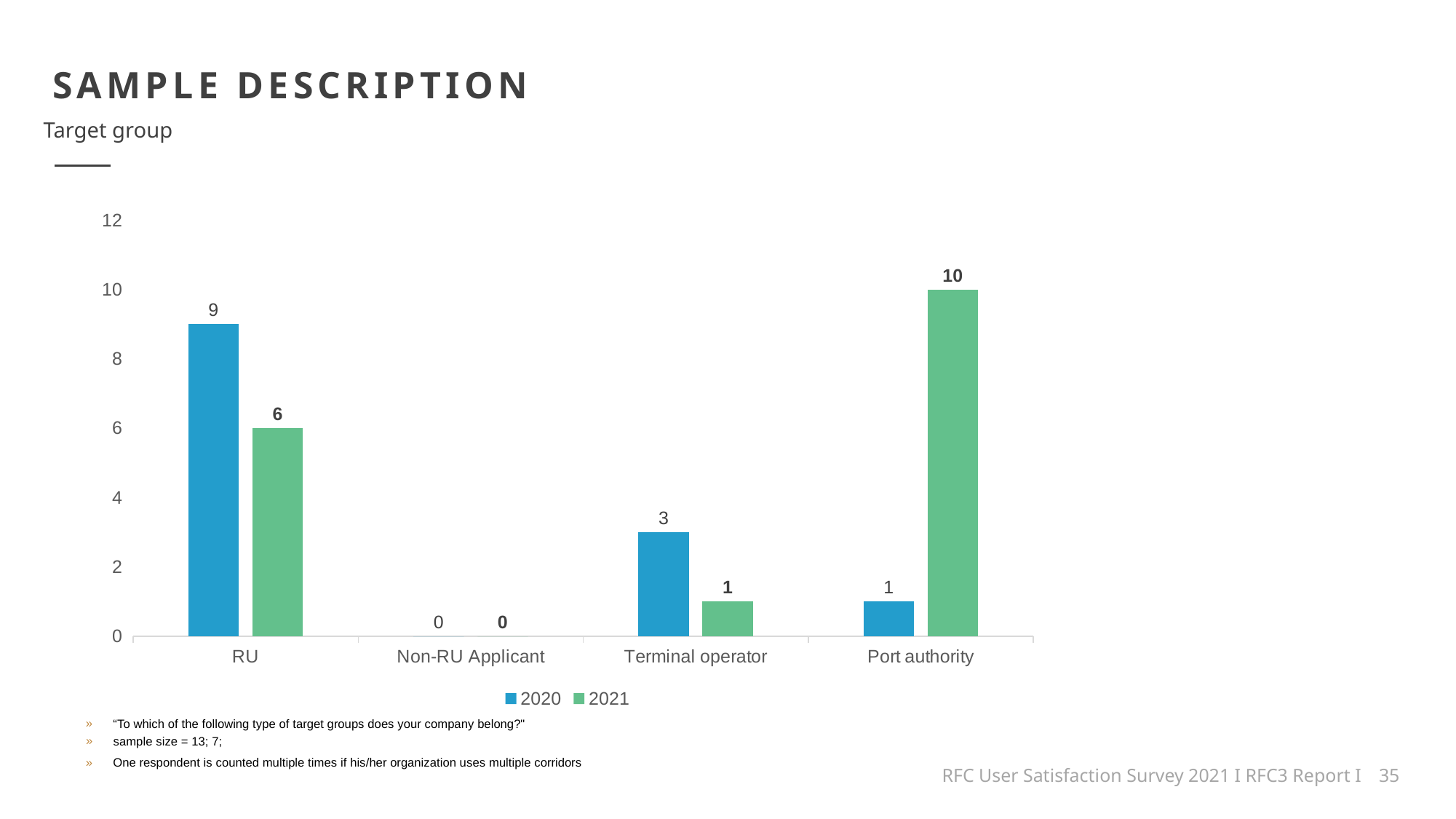
Which is larger for Terminal operator: the 2020 value or the 2021 value? 2020 What is the value for RU in 2020? 9 What is the value for Port authority in 2021? 10 How many series does the legend list? 2 How many target group categories are shown on the x axis? 4 What kind of chart is shown on the slide? Bar chart What is the value for Terminal operator in 2021? 1 What is the difference between the 2021 and 2020 values for Port authority? 9 Which target group has the highest value in 2020? RU What is the difference between the 2020 and 2021 values for RU? 3 Which target group has the lowest value in 2020? Non-RU Applicant Which target group has the highest value in 2021? Port authority